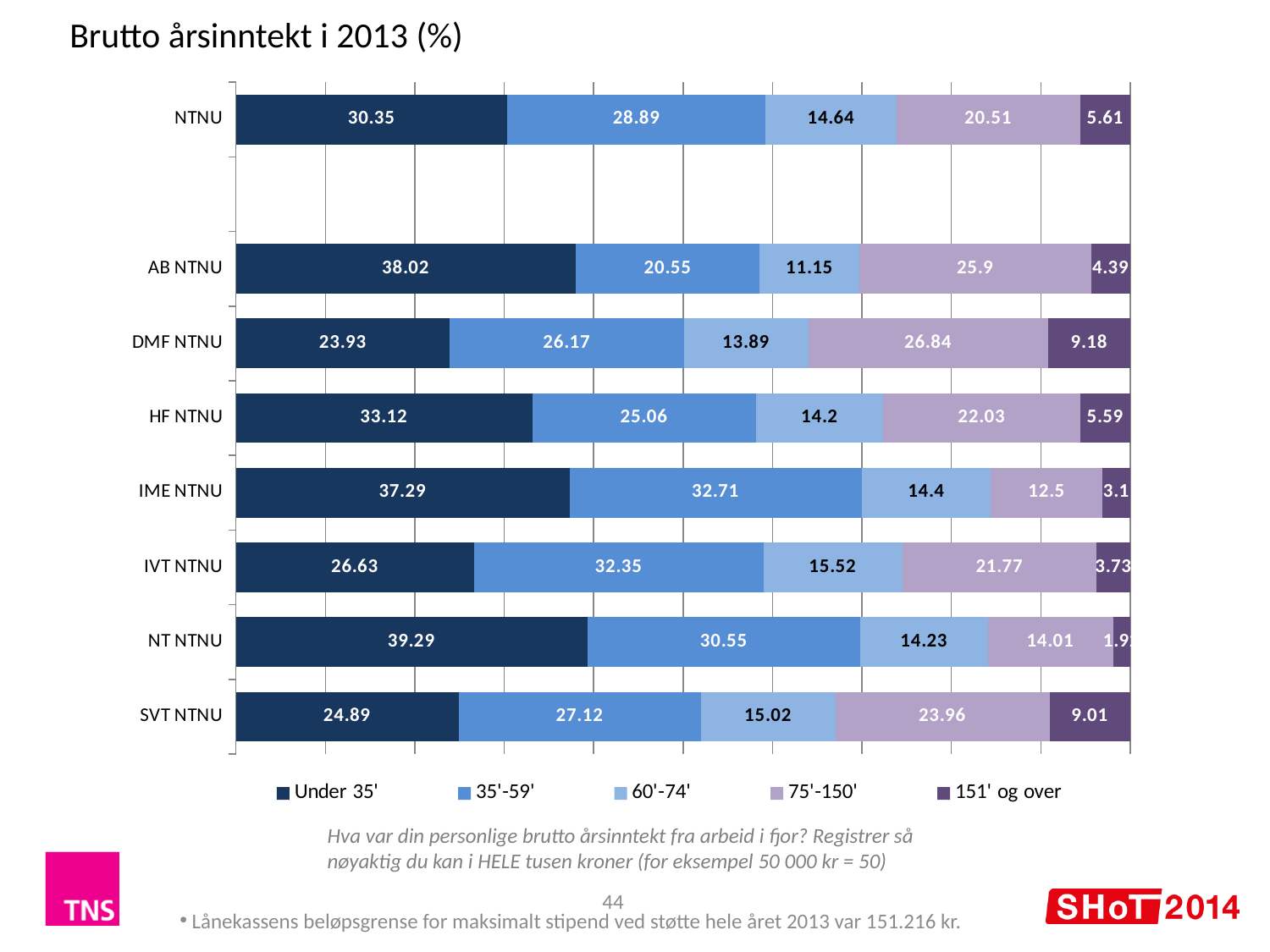
What is the value for the 'Under 35'' series for NT NTNU? 39.29 Which category has the highest value for the '151' og over' series? DMF NTNU What is the value for the '60'-74'' series for IVT NTNU? 15.52 Which category has the lowest value for the 'Under 35'' series? DMF NTNU Which is larger: the '35'-59'' value for IME NTNU or for HF NTNU? IME NTNU Which category has the highest value for the 'Under 35'' series? NT NTNU How many series does the legend list? 5 What is the value for the '75'-150'' series for DMF NTNU? 26.84 What kind of chart is shown on the slide? Stacked bar chart What is the total of the stacked bar for NTNU? 100 What is the difference between the 'Under 35'' values for AB NTNU and SVT NTNU? 13.13 How many categories are shown on the y axis? 8